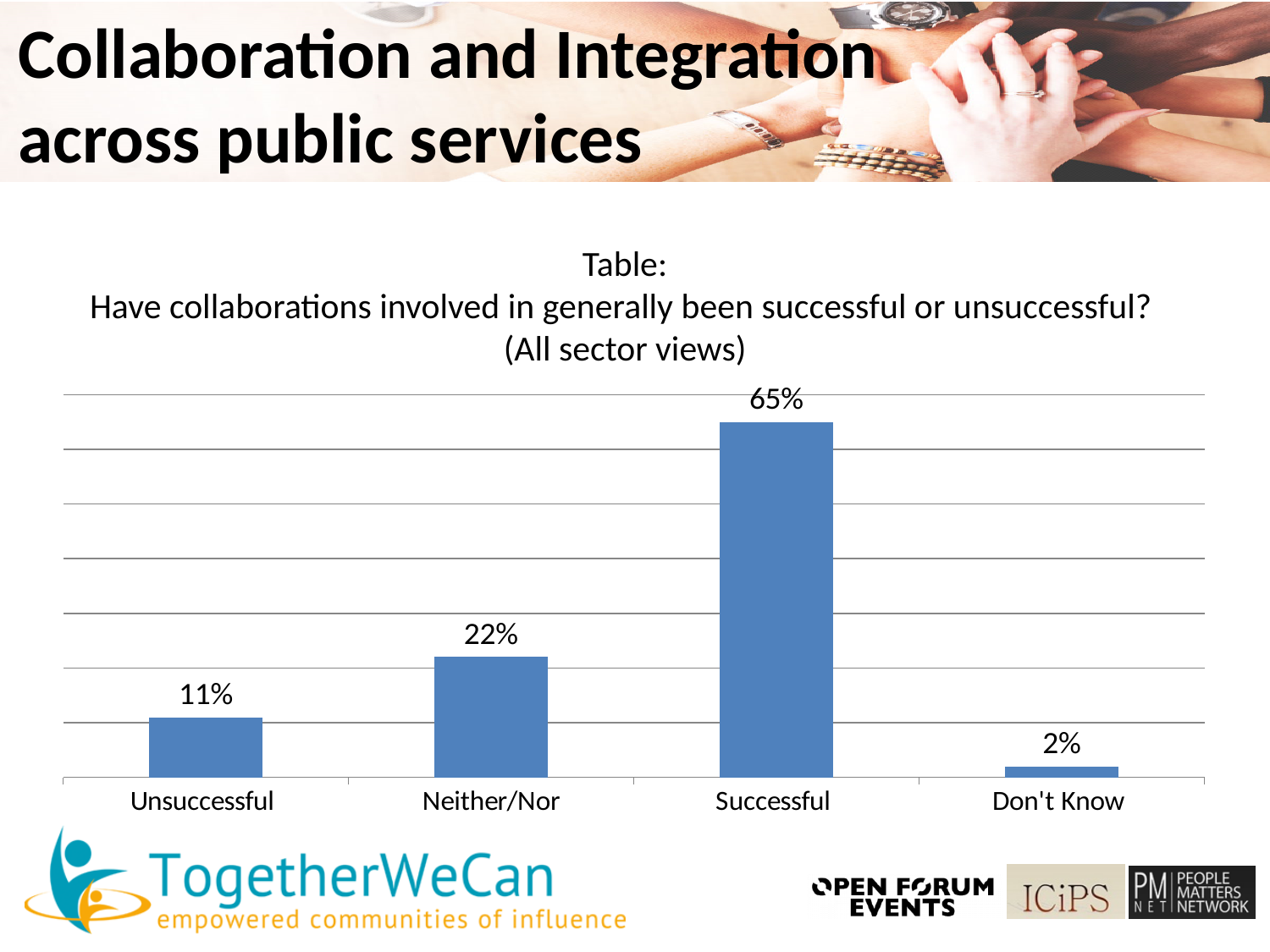
What kind of chart is shown on the slide? Bar chart Which category has the lowest value? Don't Know How many categories are shown on the x axis? 4 What is the value for Don't Know? 2% Which category has the highest value? Successful What is the value for Neither/Nor? 22% What is the difference between the Neither/Nor and Unsuccessful values? 11% What is the difference between the Successful and Unsuccessful values? 54% Which is larger, the value for Neither/Nor or the value for Unsuccessful? Neither/Nor What percentage of respondents said collaborations were Successful? 65% What is the value for Unsuccessful? 11% What question does the chart title say respondents were asked? Have collaborations involved in generally been successful or unsuccessful?